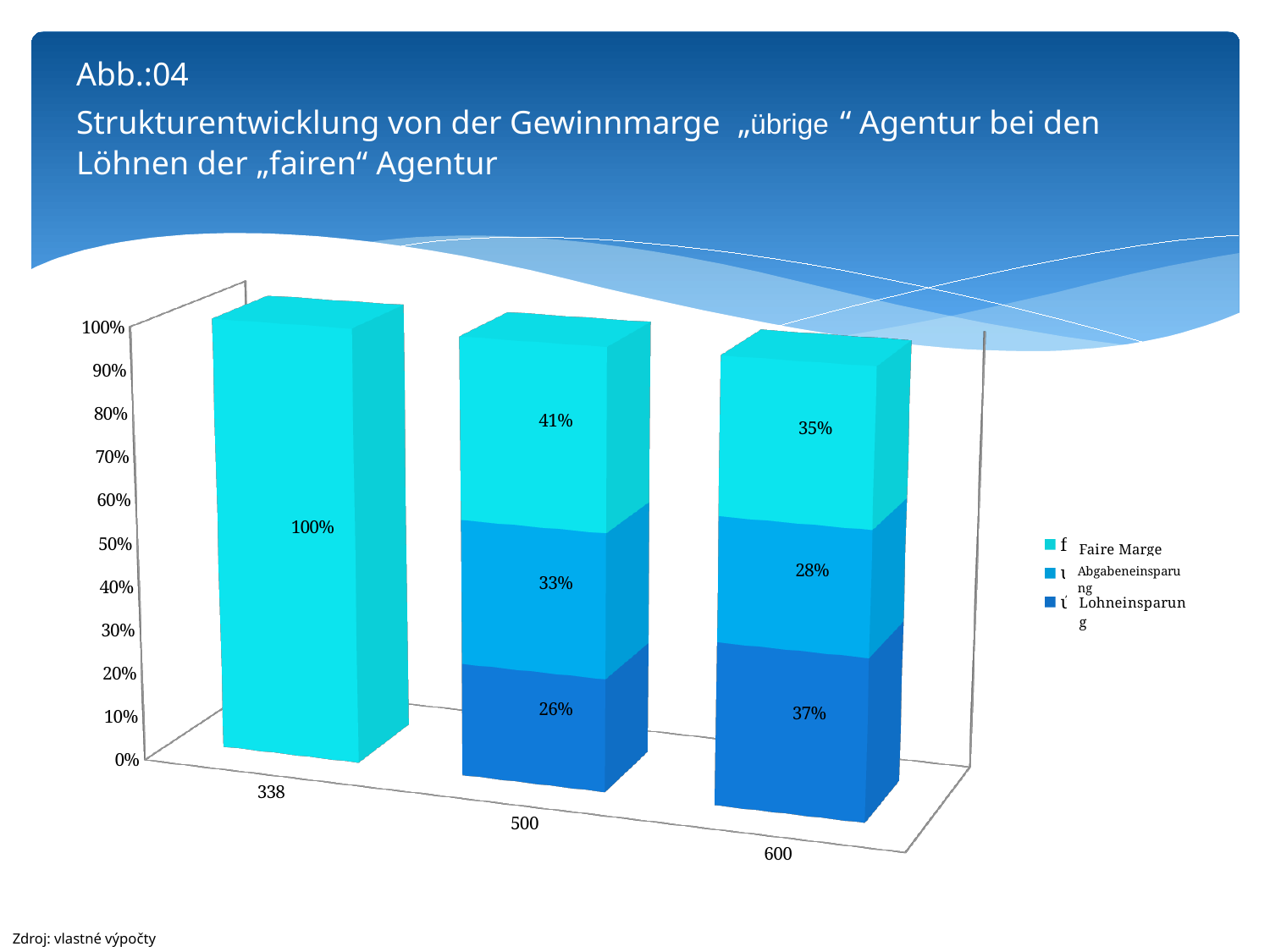
What is the value of Abgabeneinsparung for category 500? 33% Which category has the highest Faire Marge value? 338 What is the value of Lohneinsparung for category 600? 37% Which category has the lowest Faire Marge value? 600 How many series does the legend list? 3 What is the value of Faire Marge for category 500? 41% What is the value of Faire Marge for category 338? 100% Which is larger: Abgabeneinsparung for 500 or Abgabeneinsparung for 600? Abgabeneinsparung for 500 What kind of chart is shown on the slide? Stacked bar chart What is the difference between the Lohneinsparung values for 600 and 500? 11% How many categories are shown on the x axis? 3 Does the Faire Marge value rise or fall from 338 to 600? Fall